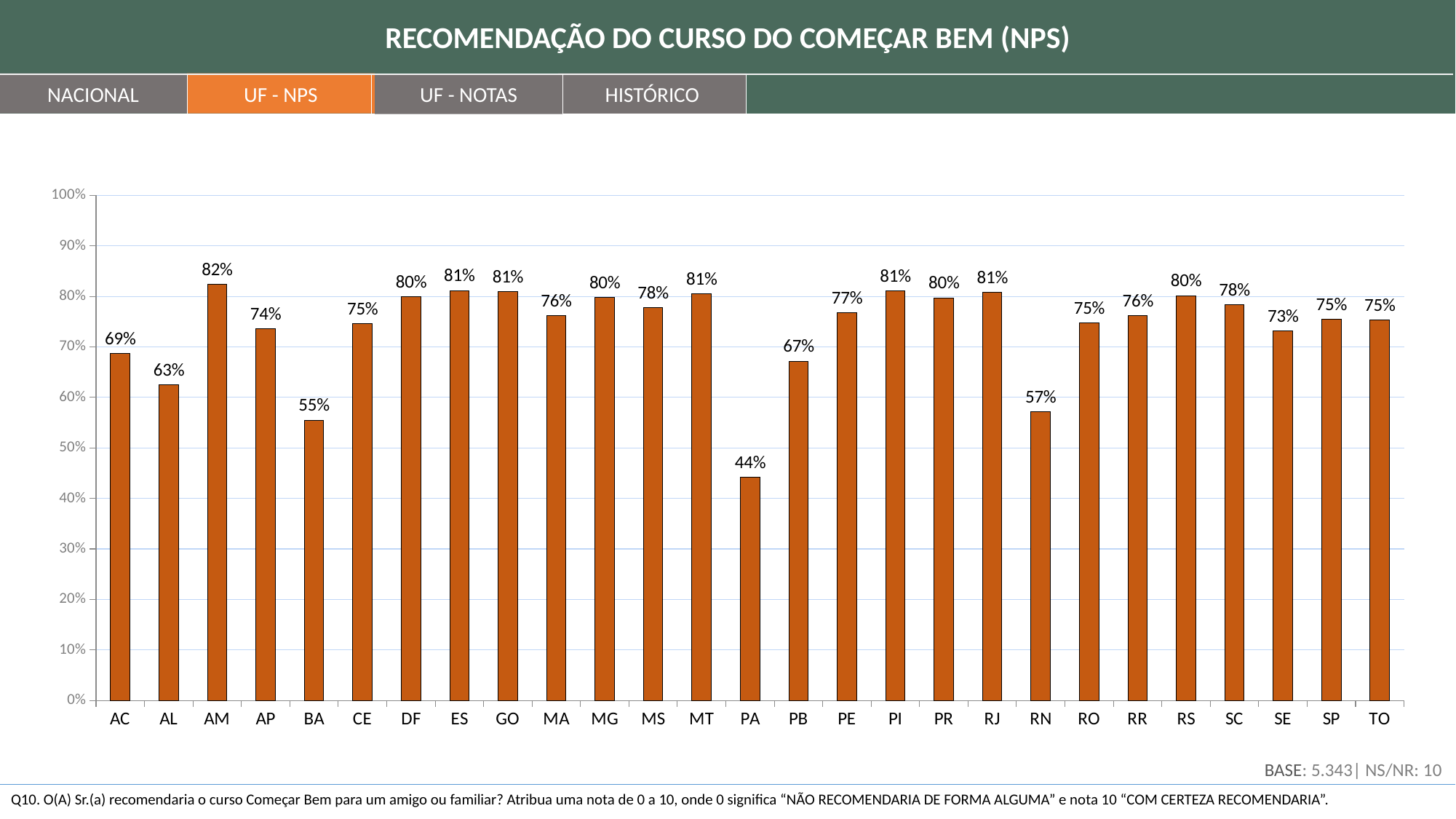
Which state has the highest value? AM What kind of chart is shown on the slide? Bar chart Which state has the lowest value? PA What is the value for BA? 55% How many states are shown on the x axis? 27 What is the difference between the values for AM and PA? 38% What is the value for SE? 73% Which is larger, the value for BA or the value for PB? PB What is the title of the slide? RECOMENDAÇÃO DO CURSO DO COMEÇAR BEM (NPS) What is the value for PB? 67% What is the difference between the values for AC and AL? 6% What is the value for RN? 57%